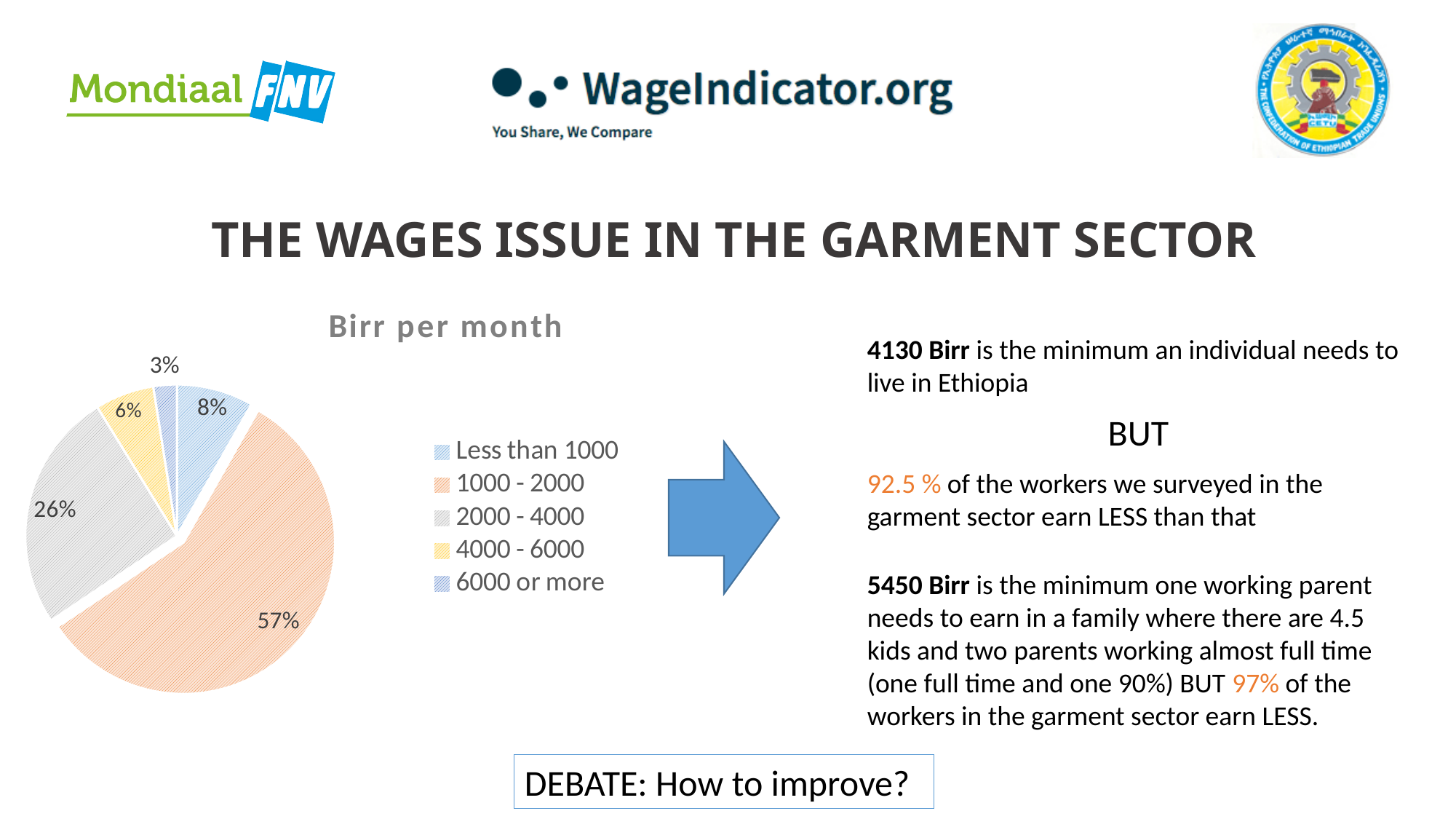
Which wage category has the largest share of the pie? 1000 - 2000 Which slice is larger: Less than 1000 or 4000 - 6000? Less than 1000 What is the combined share of the 4000 - 6000 and 6000 or more slices? 9% What is the title of the pie chart? Birr per month What is the difference in percentage points between the 1000 - 2000 slice and the 2000 - 4000 slice? 31 What share of workers earn less than 1000 Birr per month? 8% How many wage categories does the pie chart show? 5 What kind of chart is shown on the slide? Pie chart Which wage category has the smallest share of the pie? 6000 or more What share of workers earn 2000 - 4000 Birr per month? 26% What share of workers earn 6000 Birr or more per month? 3% What share of workers earn 1000 - 2000 Birr per month? 57%